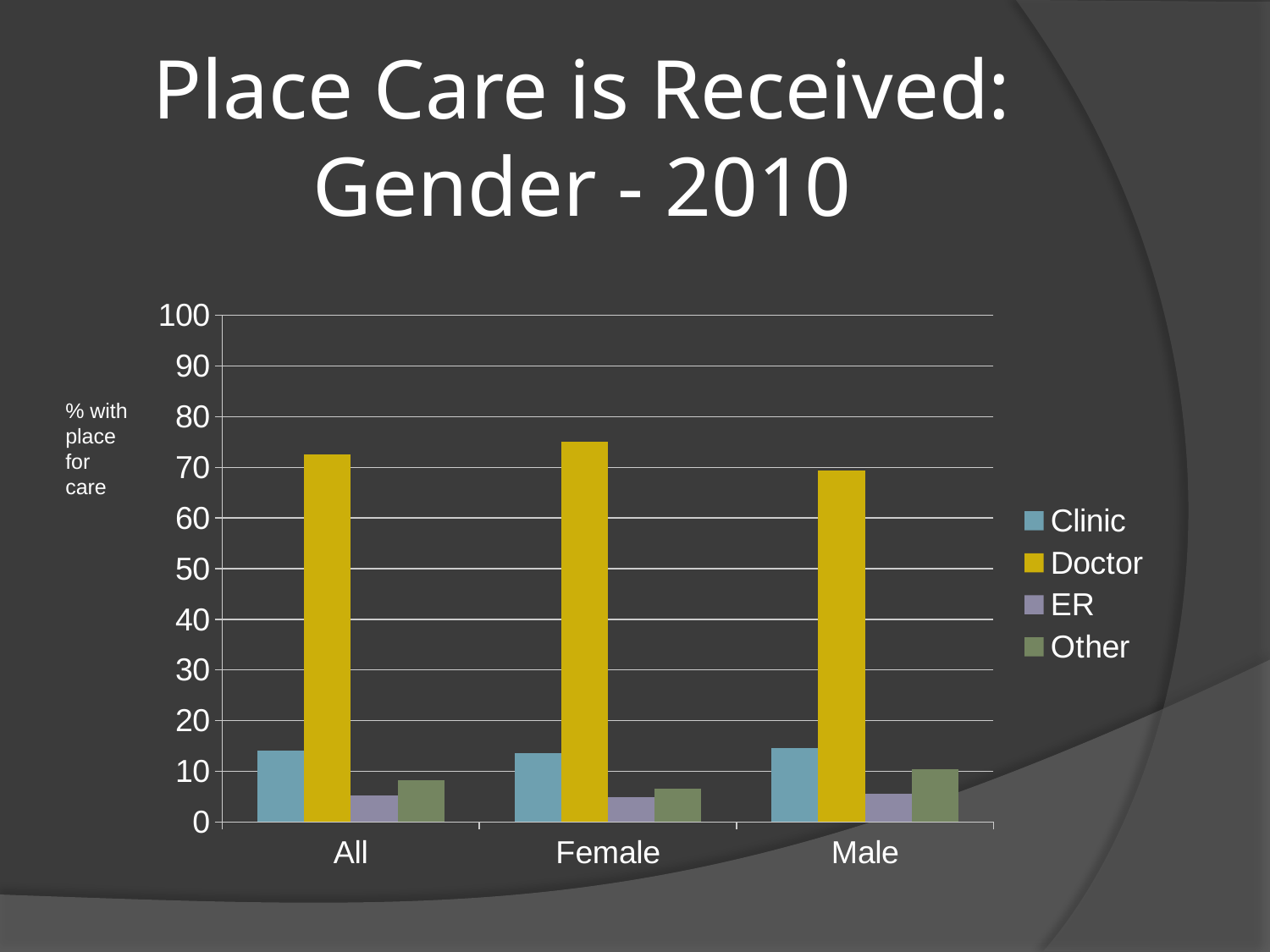
Which is larger, the Doctor value for Female or the Doctor value for Male? Female Which category has the tallest Doctor bar? Female Which is larger, the Other value for Male or the Other value for Female? Male Which series has the highest value for Female? Doctor Which series has the lowest value for All? ER What colour represents the Doctor series in the legend? yellow Is the Clinic value for All greater or less than 20? less What kind of chart is shown on the slide? bar chart Is the Other value for Male greater or less than 5? greater Is the Doctor value for Female greater or less than 70? greater How many categories are shown on the x axis? 3 How many series does the legend list? 4